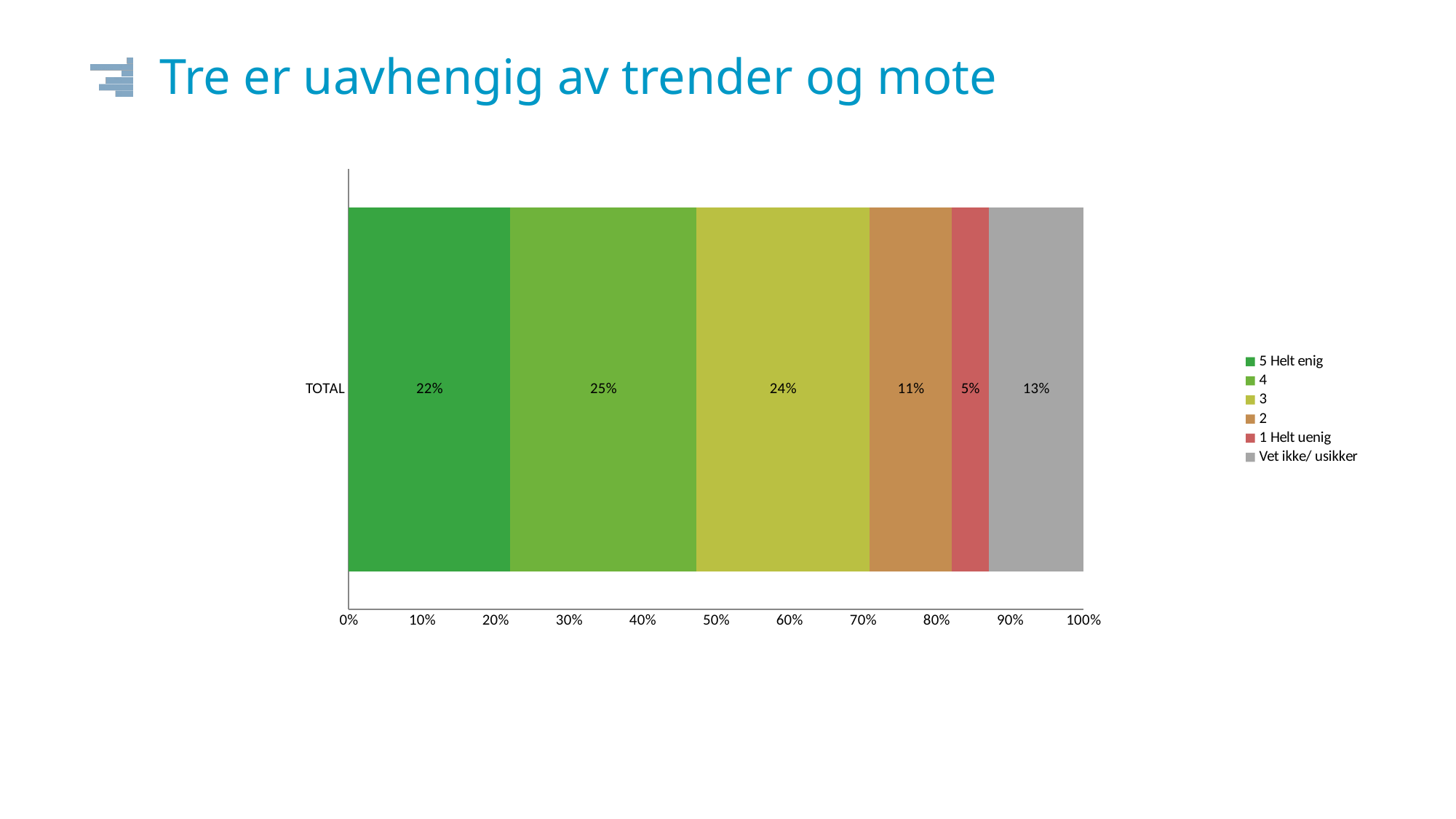
How many series does the legend list? 6 What share of respondents answered "Vet ikke/ usikker"? 13% What is the title of the slide? Tre er uavhengig av trender og mote Which is larger, the share for "3" or the share for "Vet ikke/ usikker"? 3 What is the combined share of "5 Helt enig" and "4"? 47% What percentage of respondents answered "5 Helt enig"? 22% What is the value for "1 Helt uenig"? 5% What is the difference between the share for "4" and the share for "2"? 14% What kind of chart is shown on the slide? Stacked bar chart Which response category has the smallest share in the TOTAL bar? 1 Helt uenig What is the value for the "4" series in the TOTAL bar? 25% Which response category has the largest share in the TOTAL bar? 4